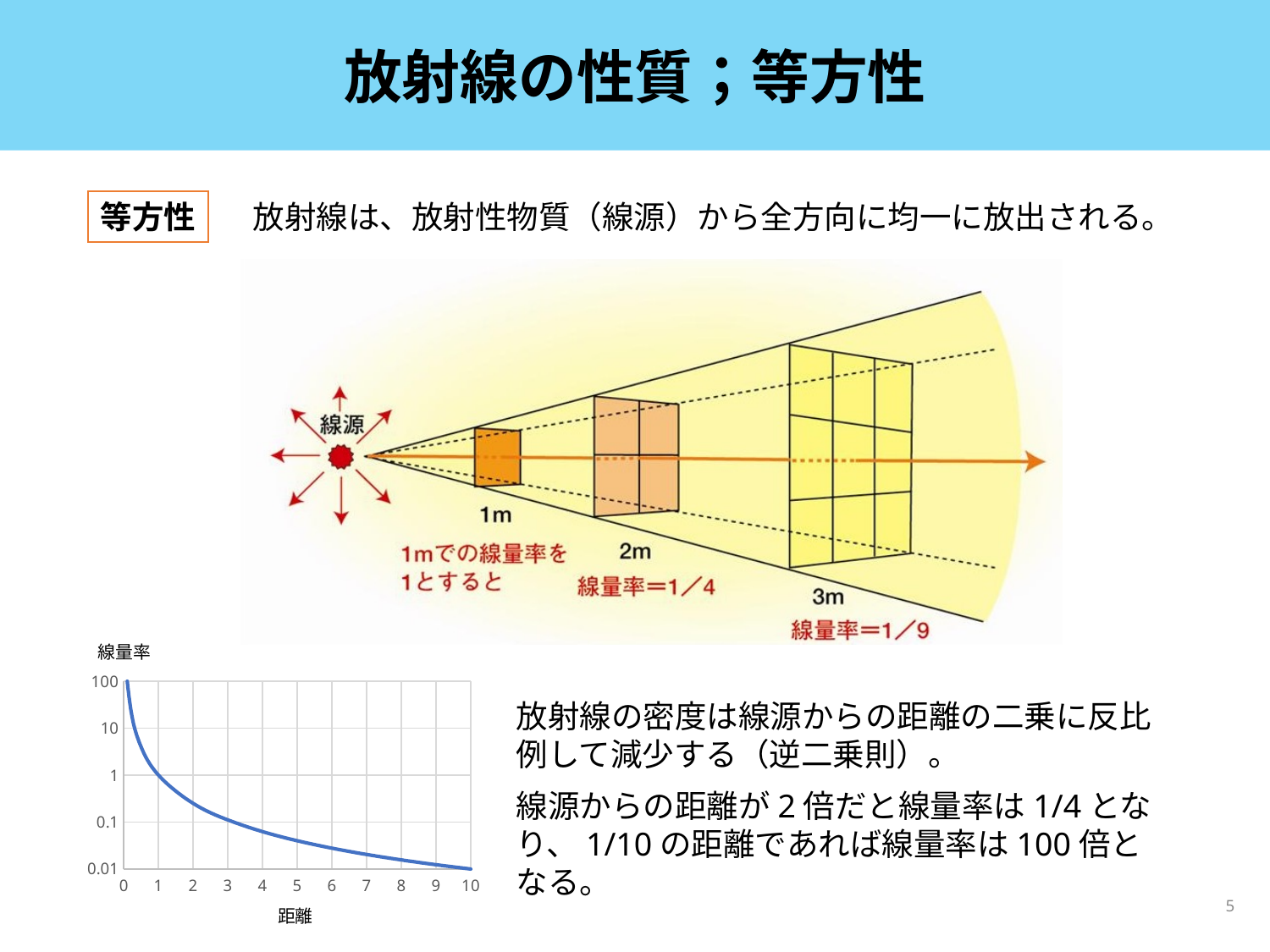
What is the label of the vertical axis of the line chart? 線量率 In the line chart, is the value at 距離 2 greater or less than 1? less How many lines are plotted in the line chart? 1 How many tick labels are shown on the horizontal axis of the line chart? 11 What is the label of the horizontal axis of the line chart? 距離 In the line chart, is the value at 距離 0.5 greater or less than 1? greater In the line chart, is the value at 距離 5 greater or less than 0.1? less In the line chart, does the 線量率 value rise or fall as 距離 increases? fall What kind of chart is shown at the bottom left of the slide? line chart In the line chart, which has the larger 線量率 value: 距離 1 or 距離 3? 距離 1 What is the highest tick value shown on the vertical axis of the line chart? 100